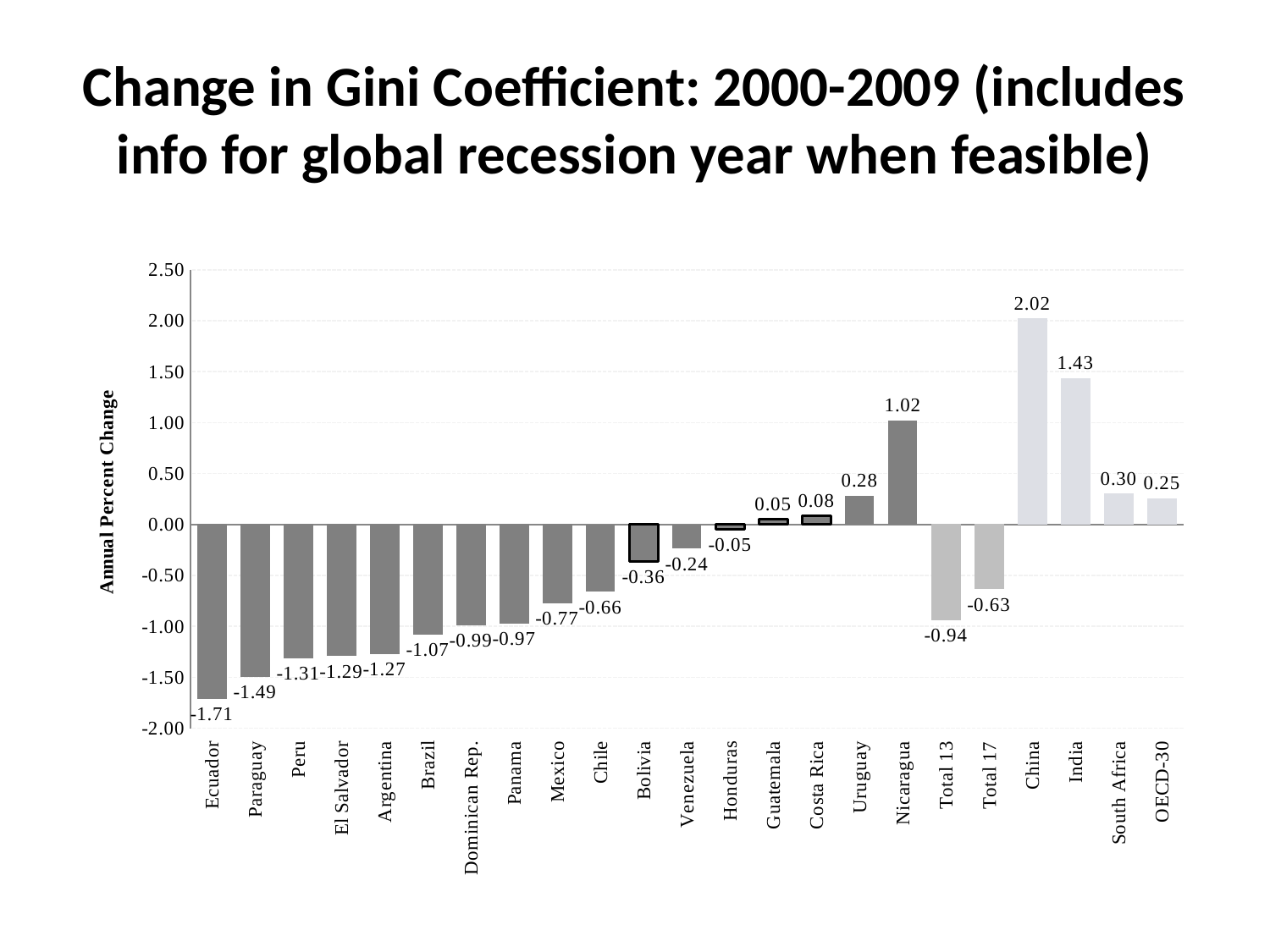
What kind of chart is this? Bar chart Which is larger, the value for South Africa or the value for OECD-30? South Africa Which category has the lowest value? Ecuador What is the value for Ecuador? -1.71 What is the difference between the values for China and India? 0.59 What is the value for Total 13? -0.94 Which category has the highest value? China What is the title of the vertical axis? Annual Percent Change What is the value for China? 2.02 What is the value for Bolivia? -0.36 How many categories are shown on the x axis? 23 What is the difference between the values for Nicaragua and Uruguay? 0.74